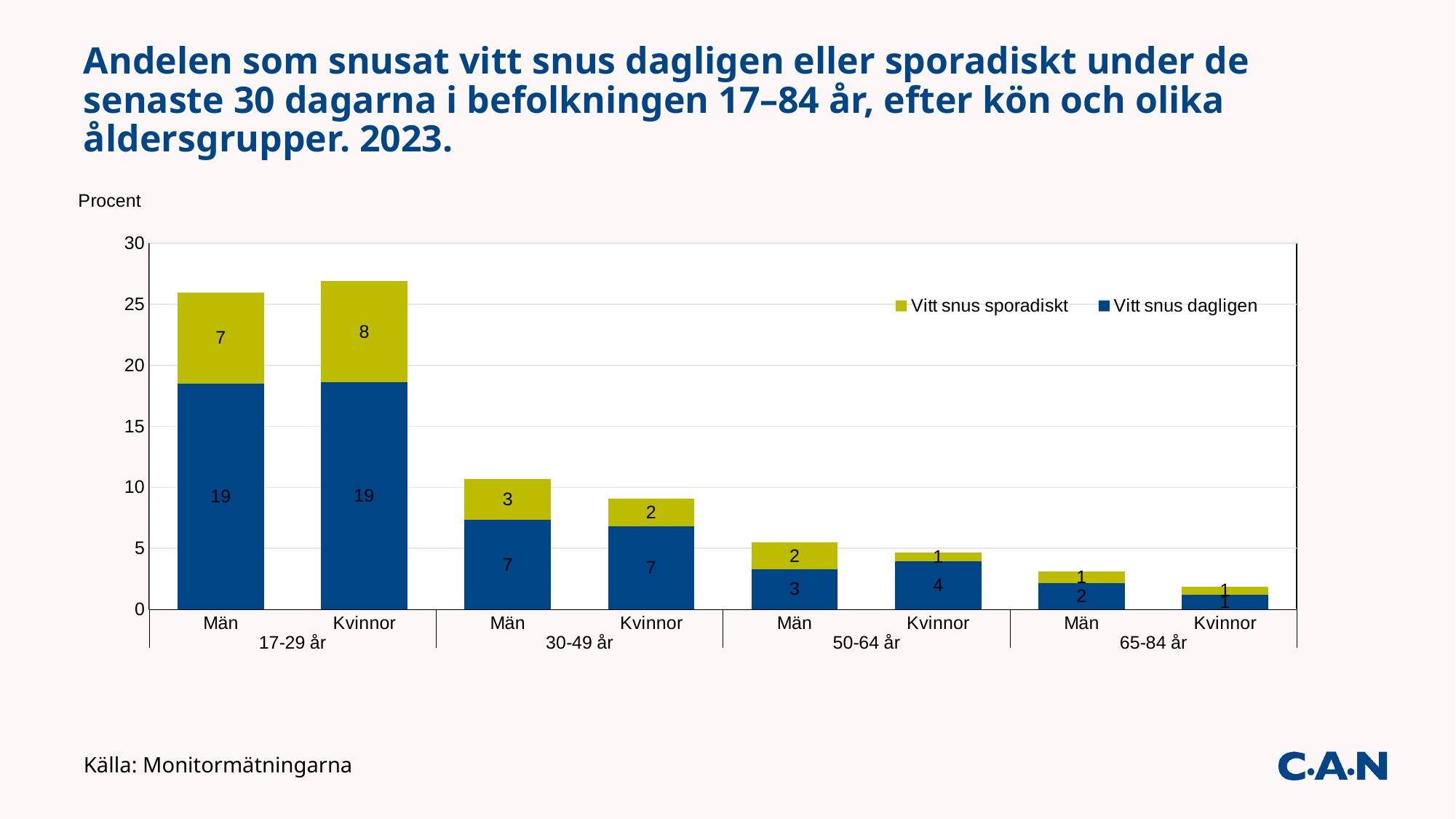
Which bar has the lowest value for 'Vitt snus dagligen'? Kvinnor, 65-84 år What is the value of 'Vitt snus sporadiskt' for Kvinnor in the 17-29 år group? 8 Is the total height of the bar for Kvinnor in the 17-29 år group greater or less than 25? greater Which bar has the highest value for 'Vitt snus sporadiskt'? Kvinnor, 17-29 år What is the difference between the 'Vitt snus dagligen' values for Män in the 17-29 år group and Män in the 30-49 år group? 12 What type of chart is shown on the slide? Stacked bar chart How many bars are plotted in the chart? 8 Which is larger, the 'Vitt snus sporadiskt' value for Män or for Kvinnor in the 30-49 år group? Män What is the total of the stacked bar for Män in the 17-29 år group, based on the printed labels? 26 How many series does the legend list? 2 What is the value of 'Vitt snus dagligen' for Kvinnor in the 50-64 år group? 4 What is the value of 'Vitt snus dagligen' for Män in the 17-29 år group? 19